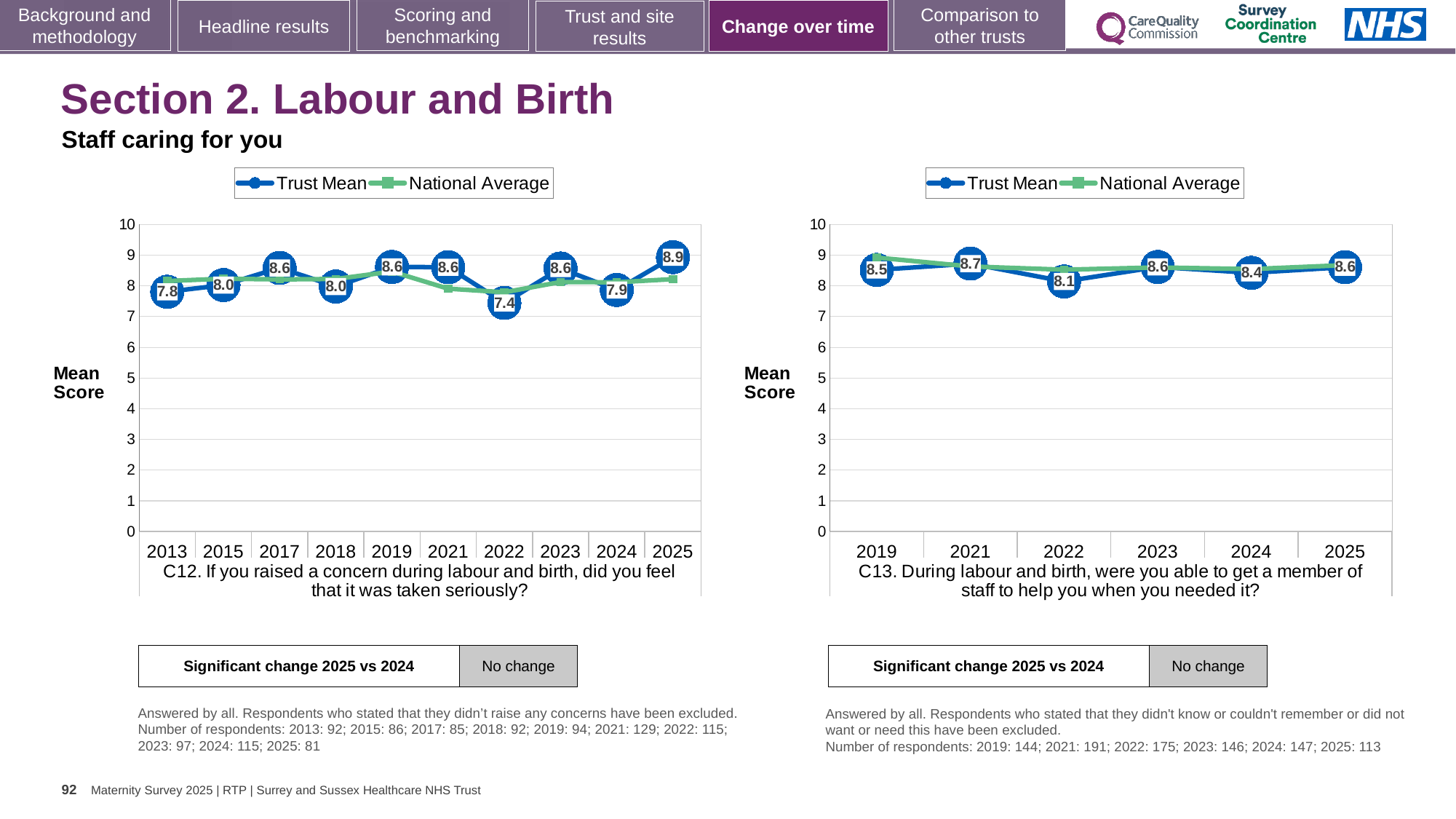
In the C13 chart on the right, is the Trust Mean value for 2022 greater or less than 7? greater In the C12 chart on the left, which year has the lowest Trust Mean score? 2022 In the C12 chart on the left, what is the Trust Mean score for 2025? 8.9 How many years are plotted on the x axis of the C12 chart on the left? 10 In the C13 chart on the right, which year has the lowest Trust Mean score? 2022 What kind of chart is the C12 chart on the left? Line chart In the C12 chart on the left, which year has the highest Trust Mean score? 2025 How many series does the legend of the C13 chart on the right list? 2 In the C13 chart on the right, what is the Trust Mean score for 2021? 8.7 In the C13 chart on the right, is the Trust Mean score for 2024 larger or smaller than the score for 2025? smaller In the C12 chart on the left, what is the Trust Mean score for 2022? 7.4 In the C12 chart on the left, what is the difference between the Trust Mean scores for 2025 and 2024? 1.0